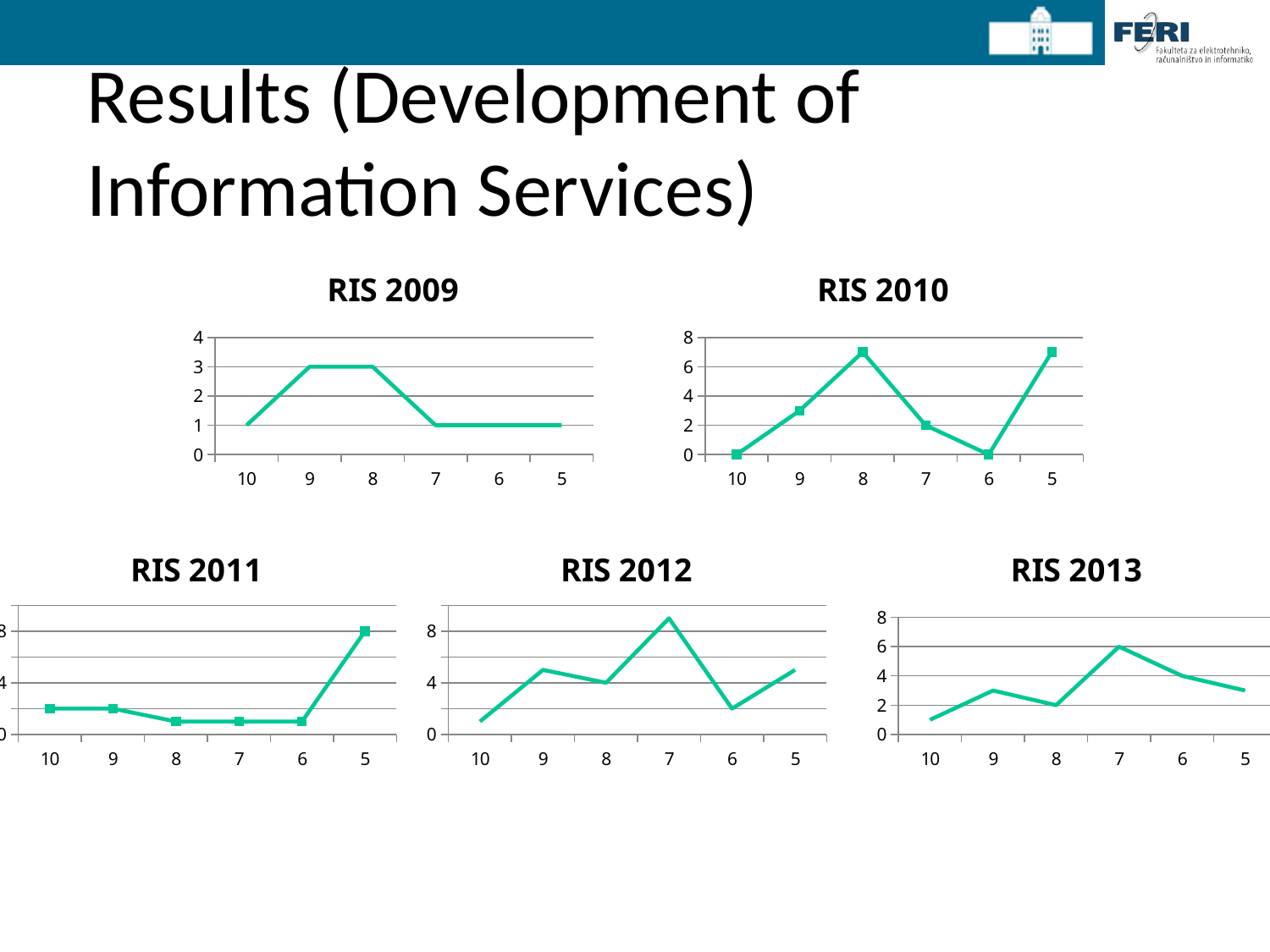
In the RIS 2012 chart, which category has the highest value? 7 How many charts are shown on the slide? 5 In the RIS 2009 chart, what is the value at category 9? 3 In the RIS 2010 chart, what is the value at category 7? 2 In the RIS 2013 chart, what is the value at category 7? 6 How many data points are plotted in the RIS 2013 chart? 6 In the RIS 2009 chart, what is the value at category 10? 1 In the RIS 2012 chart, is the value at category 7 greater or less than 8? greater What kind of chart is RIS 2009? line chart In the RIS 2009 chart, what is the difference between the values at categories 8 and 7? 2 In the RIS 2010 chart, is the value at category 8 greater or less than 6? greater In the RIS 2011 chart, which category has the highest value? 5